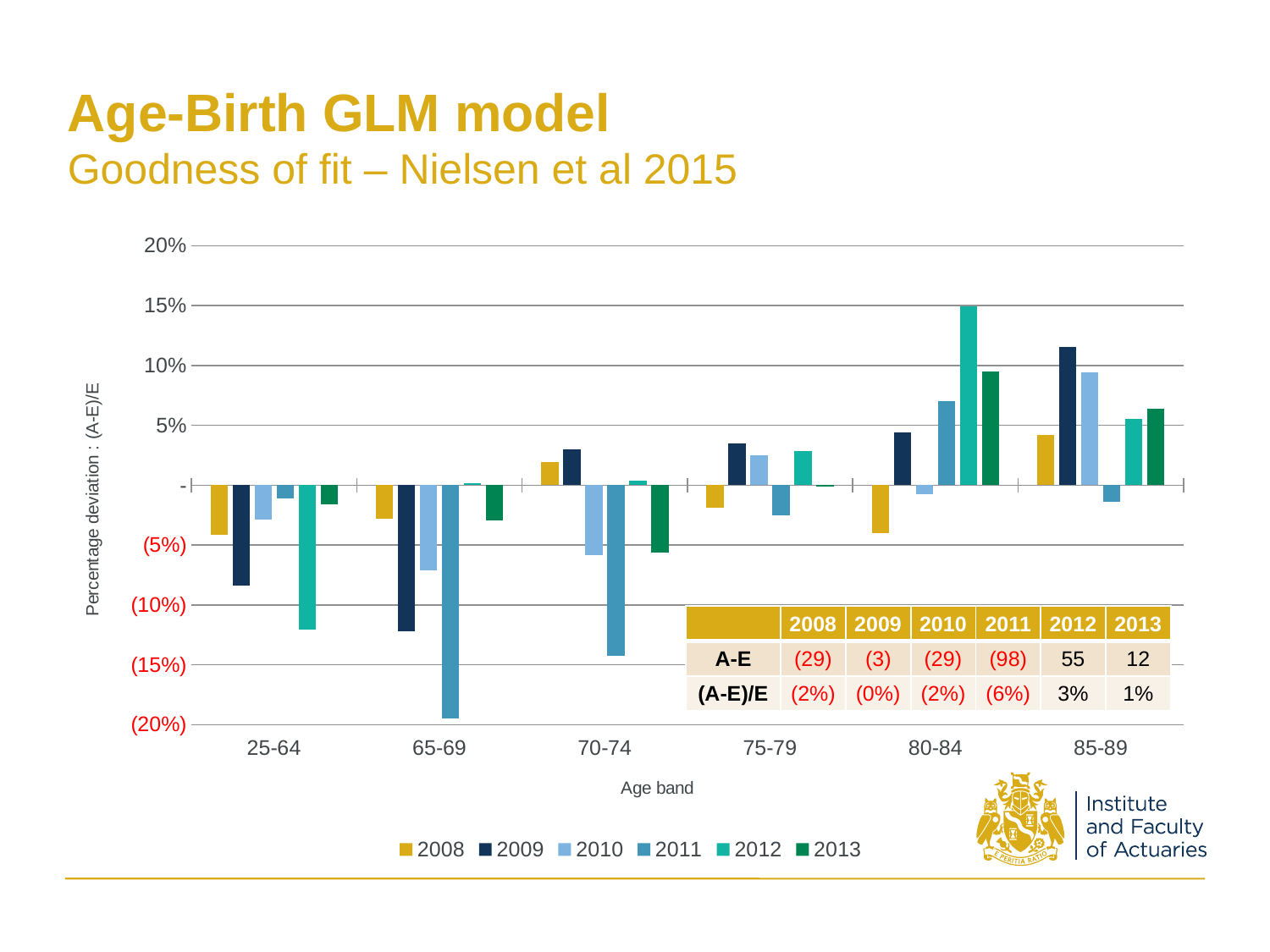
Is the value for 2011 in the 65-69 age band greater or less than (15%)? less Is the value for 2012 in the 80-84 age band greater or less than 10%? greater Which is larger, the value for 2011 in the 65-69 age band or the value for 2011 in the 70-74 age band? 2011 in 70-74 In the 80-84 age band, which series has the highest bar? 2012 Which age band and series has the highest bar in the chart? 2012 in 80-84 What kind of chart is shown on the slide? bar chart Is the value for 2011 in the 70-74 age band greater or less than (10%)? less How many series does the legend list? 6 How many age bands are shown on the x axis? 6 Which age band and series has the lowest bar in the chart? 2011 in 65-69 What is the label of the y axis? Percentage deviation : (A-E)/E